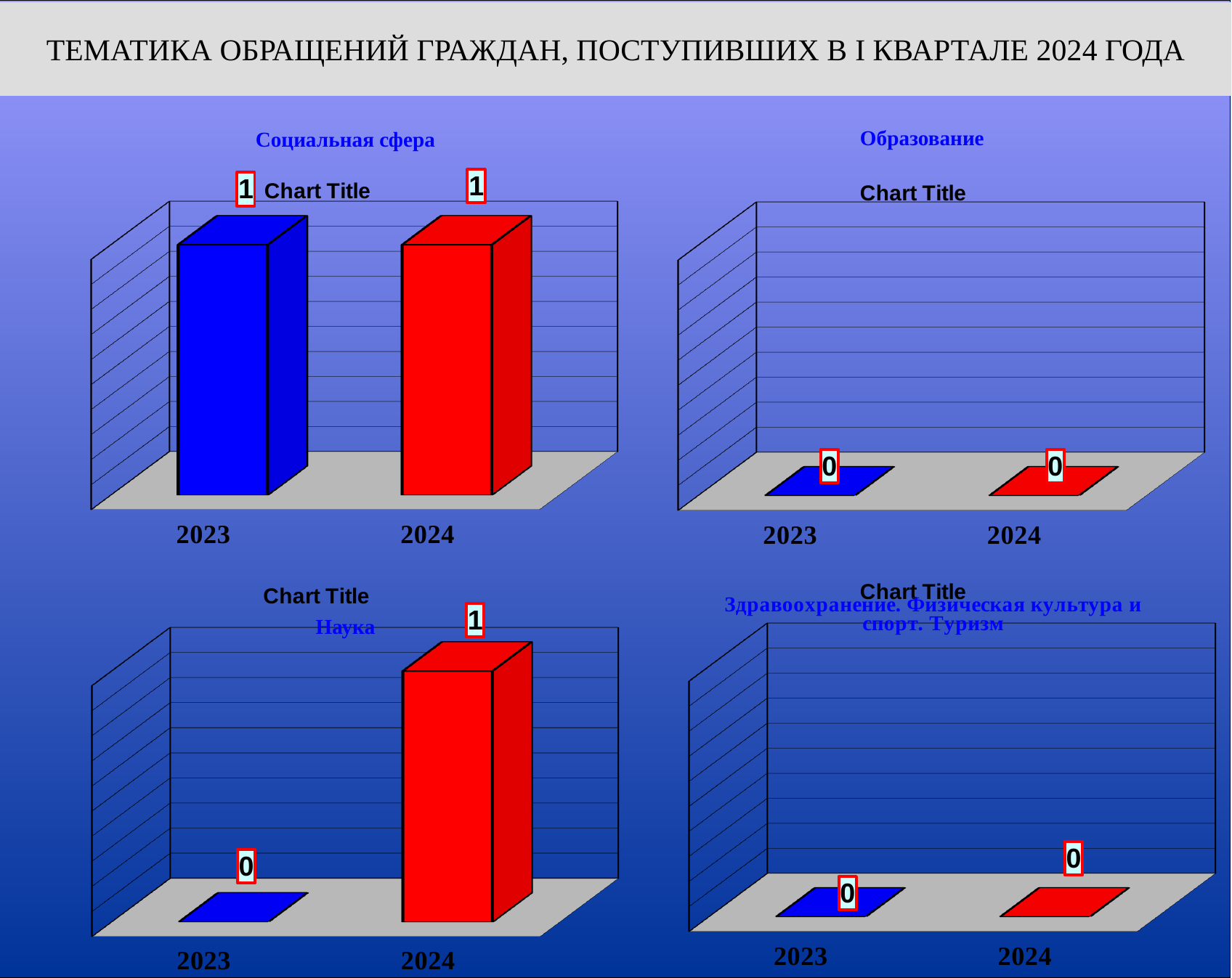
How many charts are shown on the slide? 4 In the 'Наука' chart, which year has the higher value? 2024 In the 'Образование' chart, what is the value for 2024? 0 In the 'Социальная сфера' chart, what is the value for 2023? 1 In the 'Наука' chart, what is the difference between the 2024 and 2023 values? 1 What kind of chart is the 'Социальная сфера' chart? bar chart In the 'Здравоохранение. Физическая культура и спорт. Туризм' chart, what is the value for 2023? 0 In the 'Наука' chart, what is the value for 2023? 0 In the 'Социальная сфера' chart, what is the value for 2024? 1 In the 'Наука' chart, what is the value for 2024? 1 How many categories are shown on the x axis of the 'Образование' chart? 2 In the 'Наука' chart, is the value for 2024 larger or smaller than the value for 2023? larger